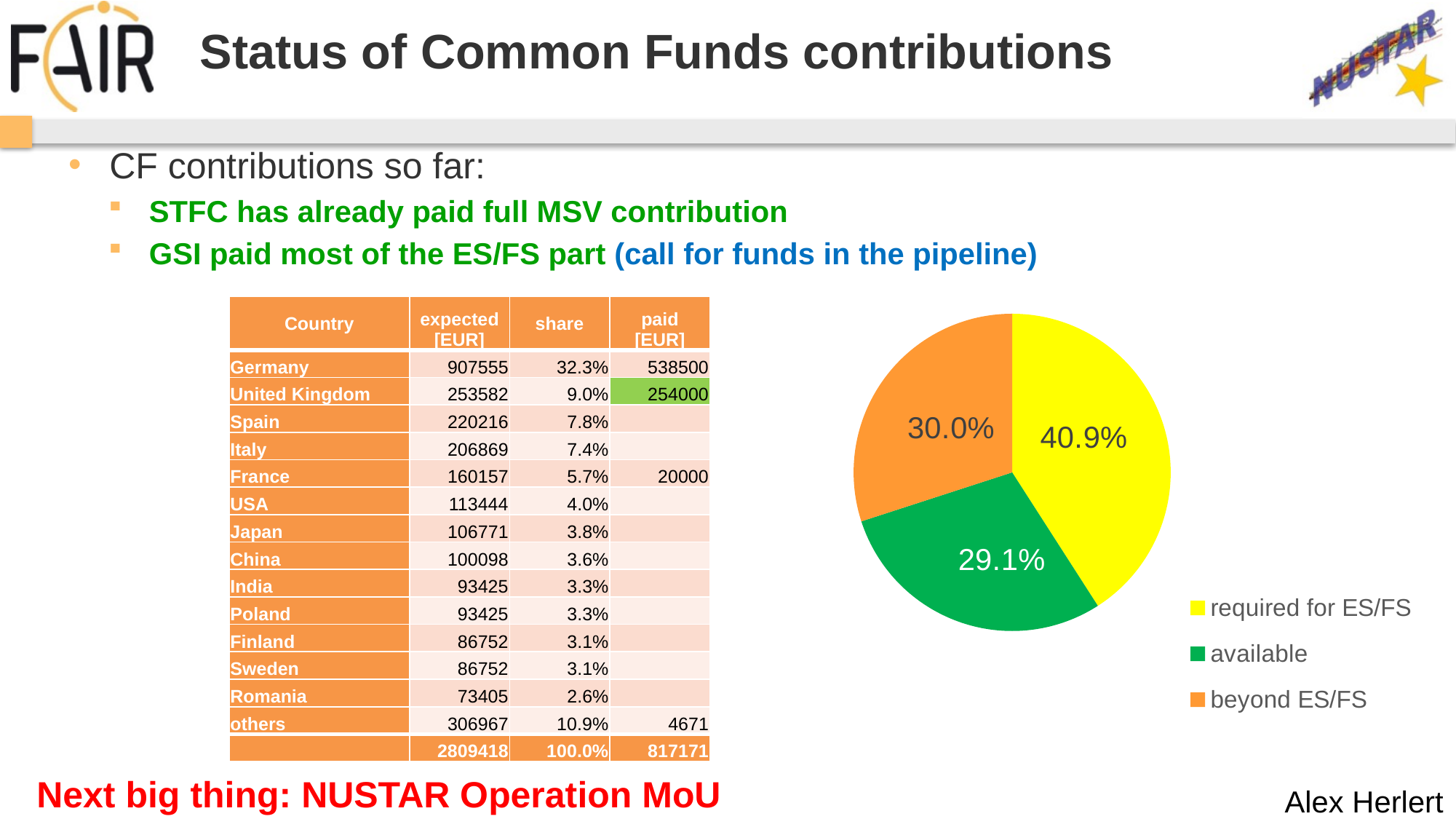
How many entries does the pie chart's legend list? 3 In the pie chart, what share is labelled for 'beyond ES/FS'? 30.0% In the pie chart, what share is labelled for 'available'? 29.1% What colour is the 'available' slice in the pie chart? green In the pie chart, what share is labelled for 'required for ES/FS'? 40.9% Which slice of the pie chart is the largest? required for ES/FS Which slice of the pie chart is the smallest? available In the pie chart, what is the difference in percentage points between 'beyond ES/FS' and 'available'? 0.9 In the pie chart, what is the difference in percentage points between 'required for ES/FS' and 'available'? 11.8 What kind of chart is shown on the right of the slide? pie chart In the pie chart, which is larger: 'required for ES/FS' or 'beyond ES/FS'? required for ES/FS How many slices does the pie chart have? 3